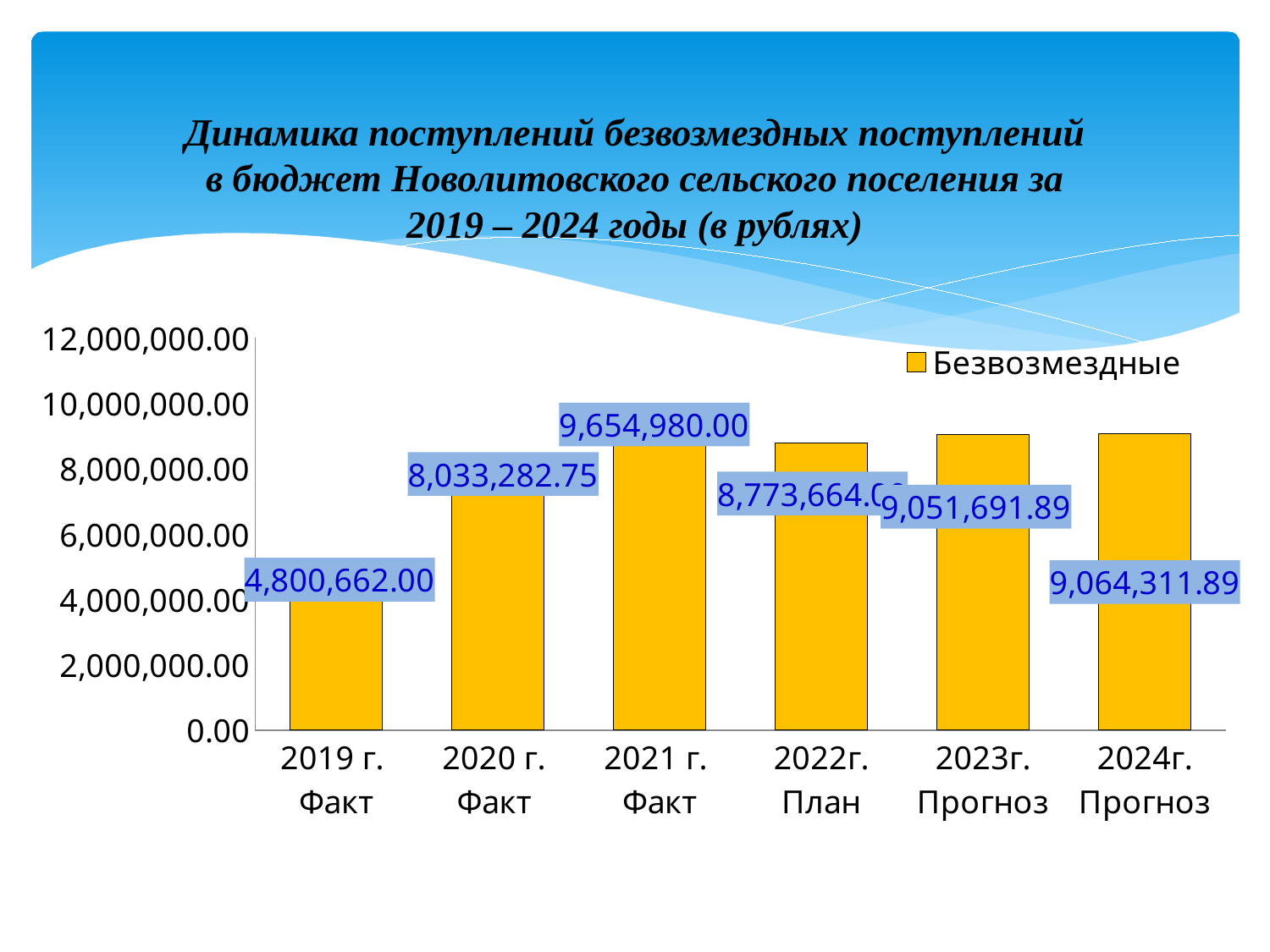
Is the value for 2022г. План greater or less than 8,000,000.00? greater What kind of chart is shown on the slide? bar chart What is the difference between the values for 2021 г. Факт and 2020 г. Факт? 1,621,697.25 What is the value for 2023г. Прогноз? 9,051,691.89 What is the value for 2024г. Прогноз? 9,064,311.89 Which category has the lowest value? 2019 г. Факт Which is larger, the value for 2020 г. Факт or 2019 г. Факт? 2020 г. Факт What series name does the legend show? Безвозмездные How many categories are shown on the x axis? 6 What is the value for 2019 г. Факт? 4,800,662.00 What is the value for 2021 г. Факт? 9,654,980.00 Which category has the highest value? 2021 г. Факт